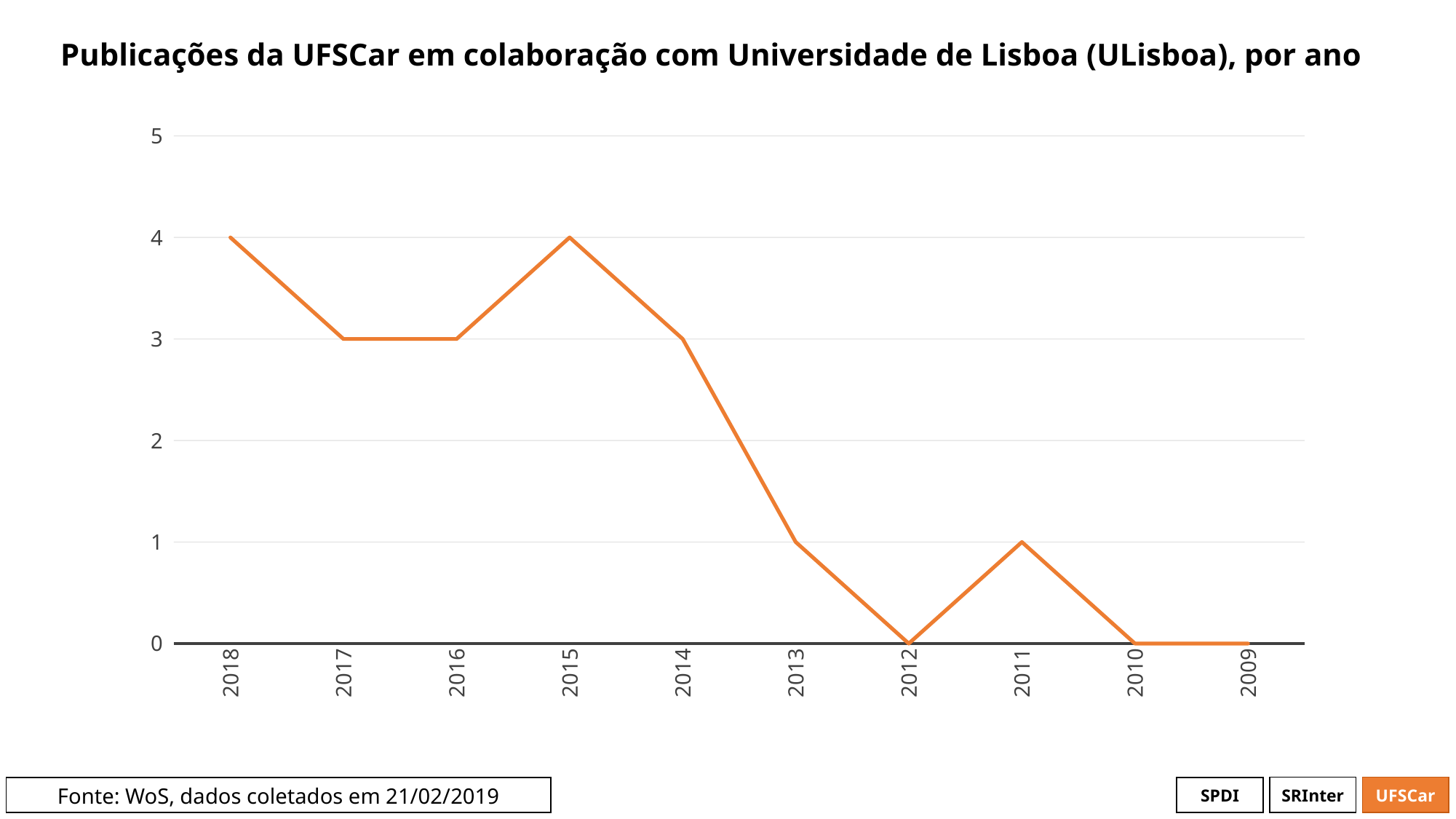
Do the values generally rise or fall moving from left (2018) to right (2009) along the x axis? fall How many years are plotted on the x axis? 10 What is the title of the chart? Publicações da UFSCar em colaboração com Universidade de Lisboa (ULisboa), por ano What is the value for 2015? 4 What kind of chart is shown on the slide? line chart What is the value for 2014? 3 What is the value for 2011? 1 What is the value for 2012? 0 Which year has the larger value, 2015 or 2014? 2015 How many publications are shown for 2018? 4 What is the value for 2013? 1 What is the difference between the values for 2018 and 2013? 3